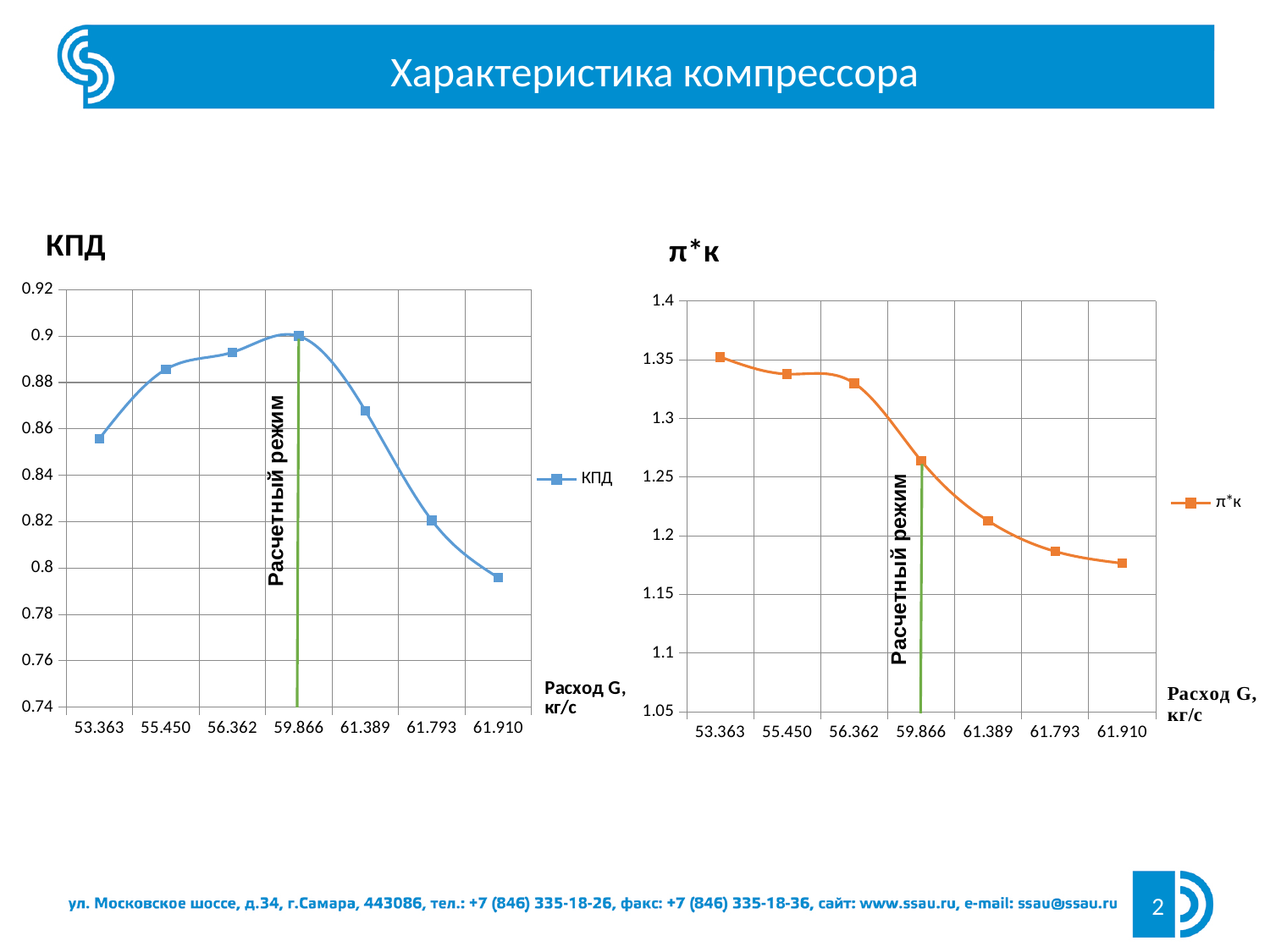
On the π*к chart, is the value at Расход G = 61.910 greater or less than 1.2? less On the КПД chart, which has the larger КПД: Расход G = 56.362 or Расход G = 61.793? 56.362 On the КПД chart, at which value of Расход G is КПД lowest? 61.910 On the КПД chart, is the value at Расход G = 61.389 greater or less than 0.86? greater How many series does the legend of the КПД chart list? 1 On the π*к chart, at which value of Расход G is π*к lowest? 61.910 How many data points are plotted on the π*к chart on the right? 7 On the π*к chart, do the values rise or fall as Расход G increases? fall What kind of chart is the КПД chart on the left? line chart What label is written on the vertical green line in both charts? Расчетный режим On the π*к chart, at which value of Расход G is π*к highest? 53.363 On the КПД chart, at which value of Расход G is КПД highest? 59.866